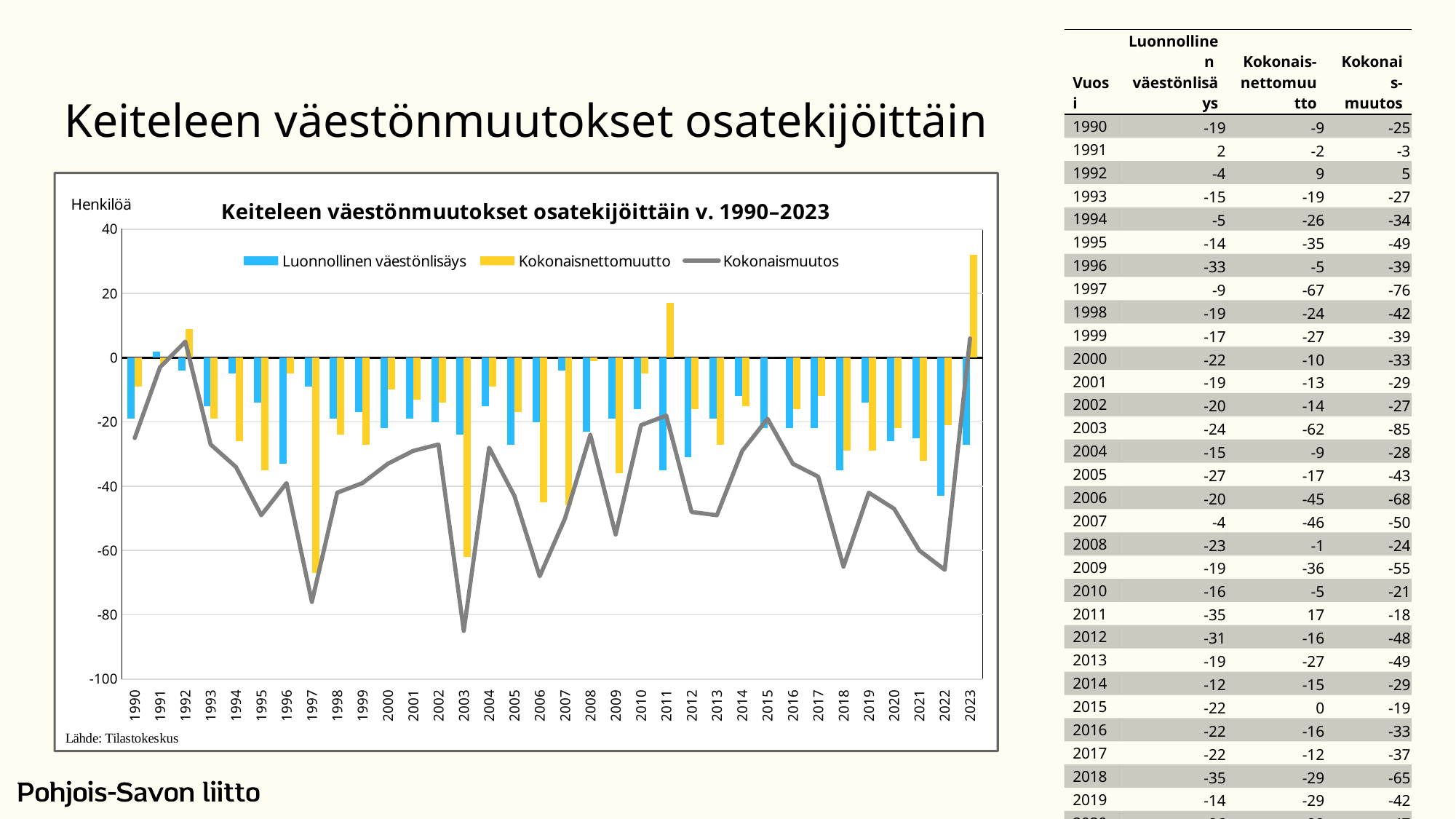
What is the difference between the Kokonaismuutos values for 1997 and 2003? 9 What is the Kokonaismuutos value for 1997? -76 How many years are shown on the x axis of the chart? 34 Which series is drawn as a grey line in the chart? Kokonaismuutos Is the Luonnollinen väestönlisäys value for 2022 greater or less than -20? less In which year is Kokonaisnettomuutto at its highest? 2023 What kind of chart is shown on the slide? bar chart with a line What is the Kokonaisnettomuutto value for 2011? 17 In which year is Kokonaismuutos at its lowest? 2003 What is the Luonnollinen väestönlisäys value for 1991? 2 Is the Kokonaisnettomuutto value for 2023 greater or less than 20? greater How many series does the chart legend list? 3